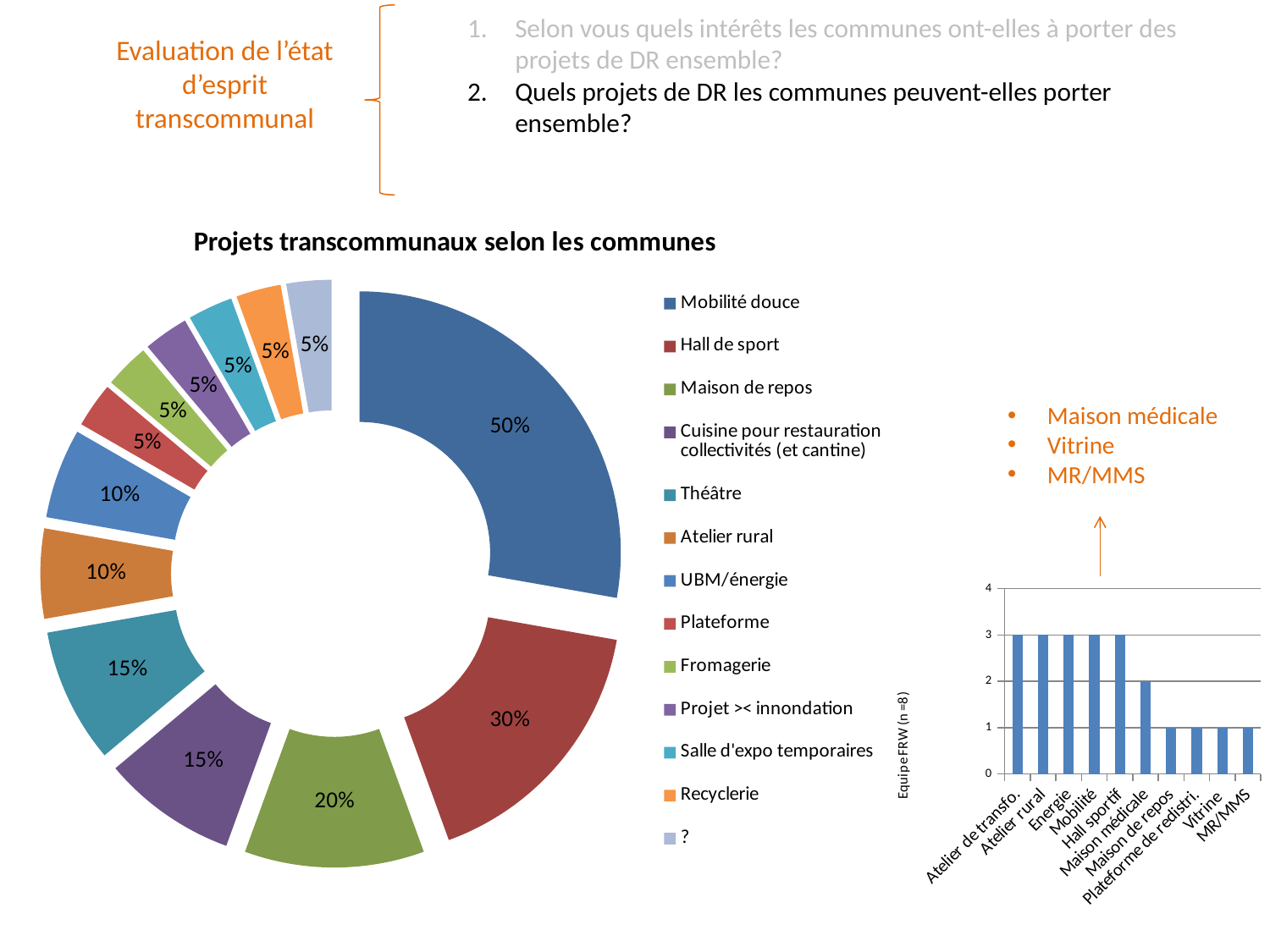
In the doughnut chart 'Projets transcommunaux selon les communes', which category has the largest share? Mobilité douce How many entries does the legend of the doughnut chart 'Projets transcommunaux selon les communes' list? 13 In the doughnut chart 'Projets transcommunaux selon les communes', what share is shown for Maison de repos? 20% In the doughnut chart 'Projets transcommunaux selon les communes', what share is shown for Mobilité douce? 50% In the doughnut chart 'Projets transcommunaux selon les communes', what is the difference between the shares of Mobilité douce and Hall de sport? 20% In the doughnut chart 'Projets transcommunaux selon les communes', which is larger: the share for Atelier rural or the share for Maison de repos? Maison de repos In the bar chart on the right of the slide, what is the value for Maison médicale? 2 How many categories are shown on the x axis of the bar chart on the right of the slide? 10 In the bar chart on the right of the slide, do the values rise or fall from left to right along the x axis? Fall In the doughnut chart 'Projets transcommunaux selon les communes', what share is shown for Hall de sport? 30% In the bar chart on the right of the slide, what is the value for Vitrine? 1 What type of chart is the chart on the right of the slide with the y-axis label 'Equipe FRW (n =8)'? Bar chart